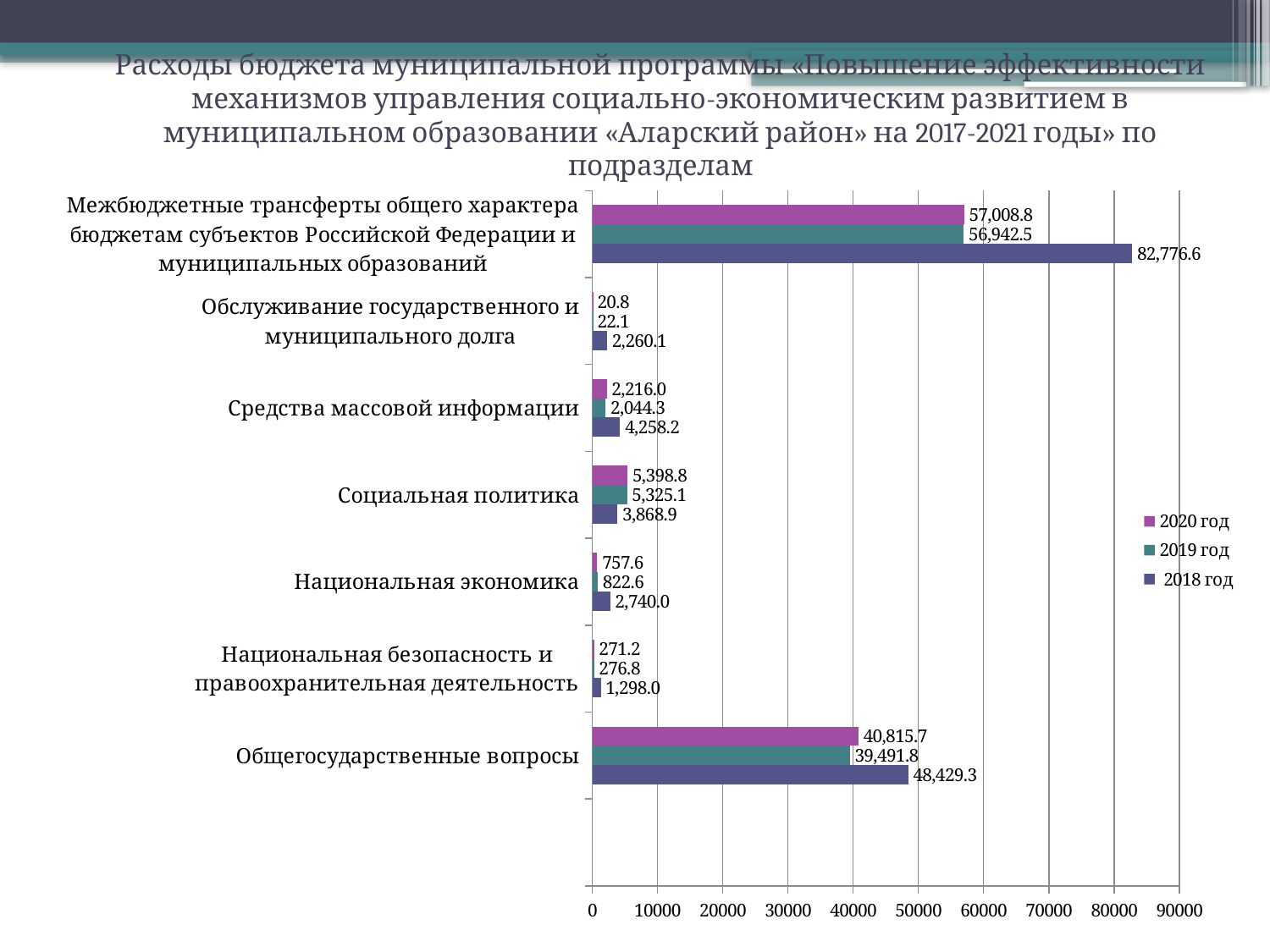
What kind of chart is shown on the slide? Bar chart Is the 2018 год value for «Общегосударственные вопросы» greater or less than 40000? greater How many series does the legend list? 3 For «Социальная политика», which is larger: the 2020 год value or the 2018 год value? 2020 год What is the value for «Общегосударственные вопросы» in the 2018 год series? 48,429.3 What is the value for «Национальная экономика» in the 2019 год series? 822.6 Which category has the lowest value in the 2020 год series? Обслуживание государственного и муниципального долга What is the difference between the 2018 год and 2020 год values for «Межбюджетные трансферты общего характера бюджетам субъектов Российской Федерации и муниципальных образований»? 25,767.8 What is the value for «Социальная политика» in the 2020 год series? 5,398.8 What is the difference between the 2018 год and 2020 год values for «Общегосударственные вопросы»? 7,613.6 How many categories are shown on the chart? 7 Which category has the highest value in the 2018 год series? Межбюджетные трансферты общего характера бюджетам субъектов Российской Федерации и муниципальных образований